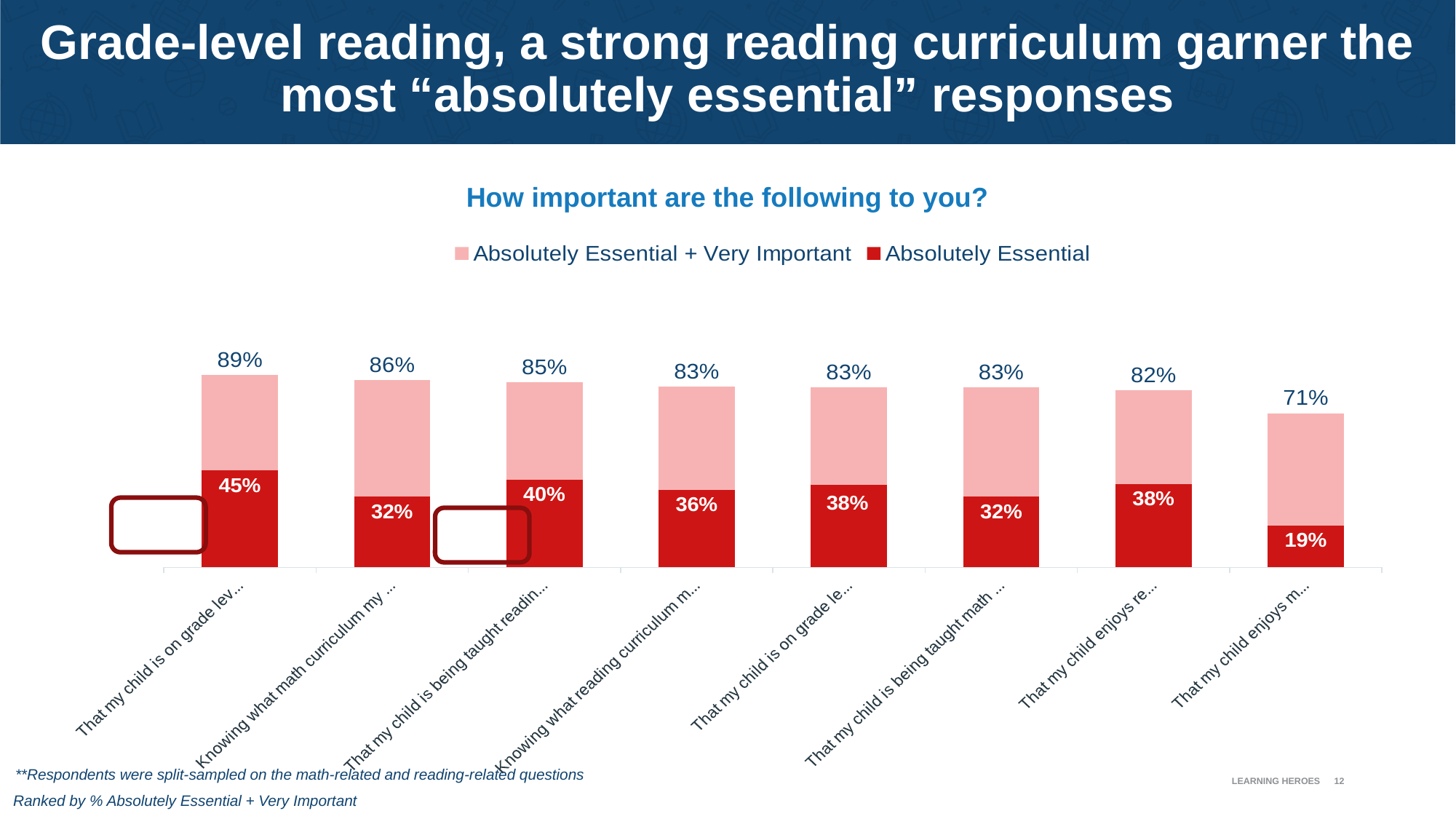
What is the "Absolutely Essential + Very Important" value for "Knowing what math curriculum my ..."? 86% What type of chart is shown on the slide? bar chart How many categories (bars) are shown in the chart? 8 What is the "Absolutely Essential" value for the first bar ("That my child is on grade lev...")? 45% What is the "Absolutely Essential + Very Important" value for the first bar ("That my child is on grade lev...")? 89% How many series does the legend list? 2 What is the title of the chart? How important are the following to you? Which category has the highest "Absolutely Essential" value? That my child is on grade lev... What is the difference between the "Absolutely Essential + Very Important" value and the "Absolutely Essential" value for the first bar? 44% Which category has the lowest "Absolutely Essential + Very Important" value? That my child enjoys m... Which is larger: the "Absolutely Essential" value for "That my child is being taught readin..." or for "Knowing what math curriculum my ..."? That my child is being taught readin... What is the "Absolutely Essential" value for the last bar ("That my child enjoys m...")? 19%